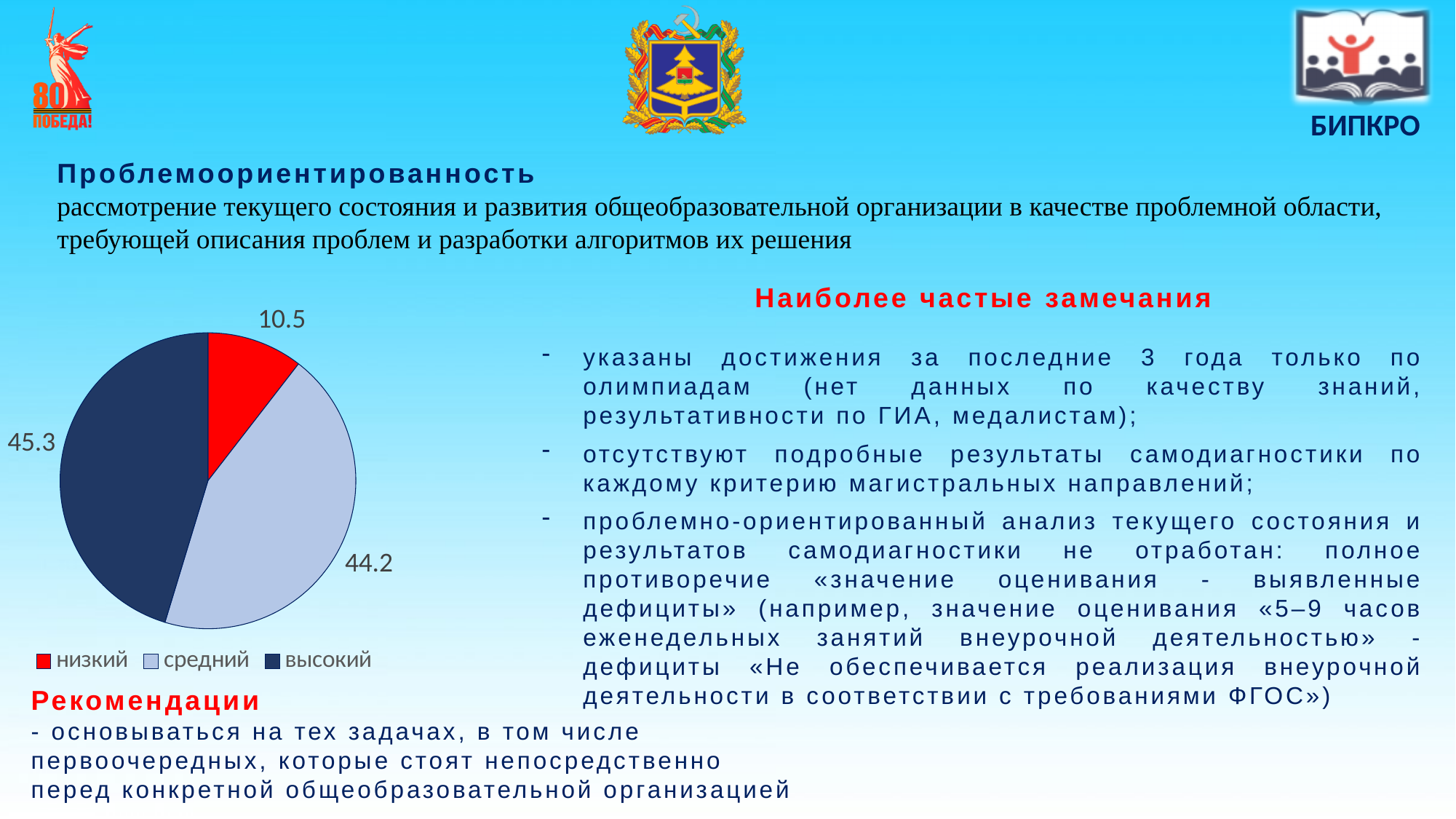
Which category has the smallest slice in the pie chart? низкий What is the value for the "высокий" slice of the pie chart? 45.3 Which is larger in the pie chart, the value for "средний" or the value for "низкий"? средний What is the difference between the values for "высокий" and "низкий" in the pie chart? 34.8 What is the value for the "низкий" slice of the pie chart? 10.5 What is the difference between the values for "средний" and "низкий" in the pie chart? 33.7 What colour is the "низкий" slice in the pie chart? red How many slices does the pie chart have? 3 How many entries does the legend of the pie chart list? 3 What is the value for the "средний" slice of the pie chart? 44.2 Which category has the largest slice in the pie chart? высокий What kind of chart is shown on the slide? pie chart